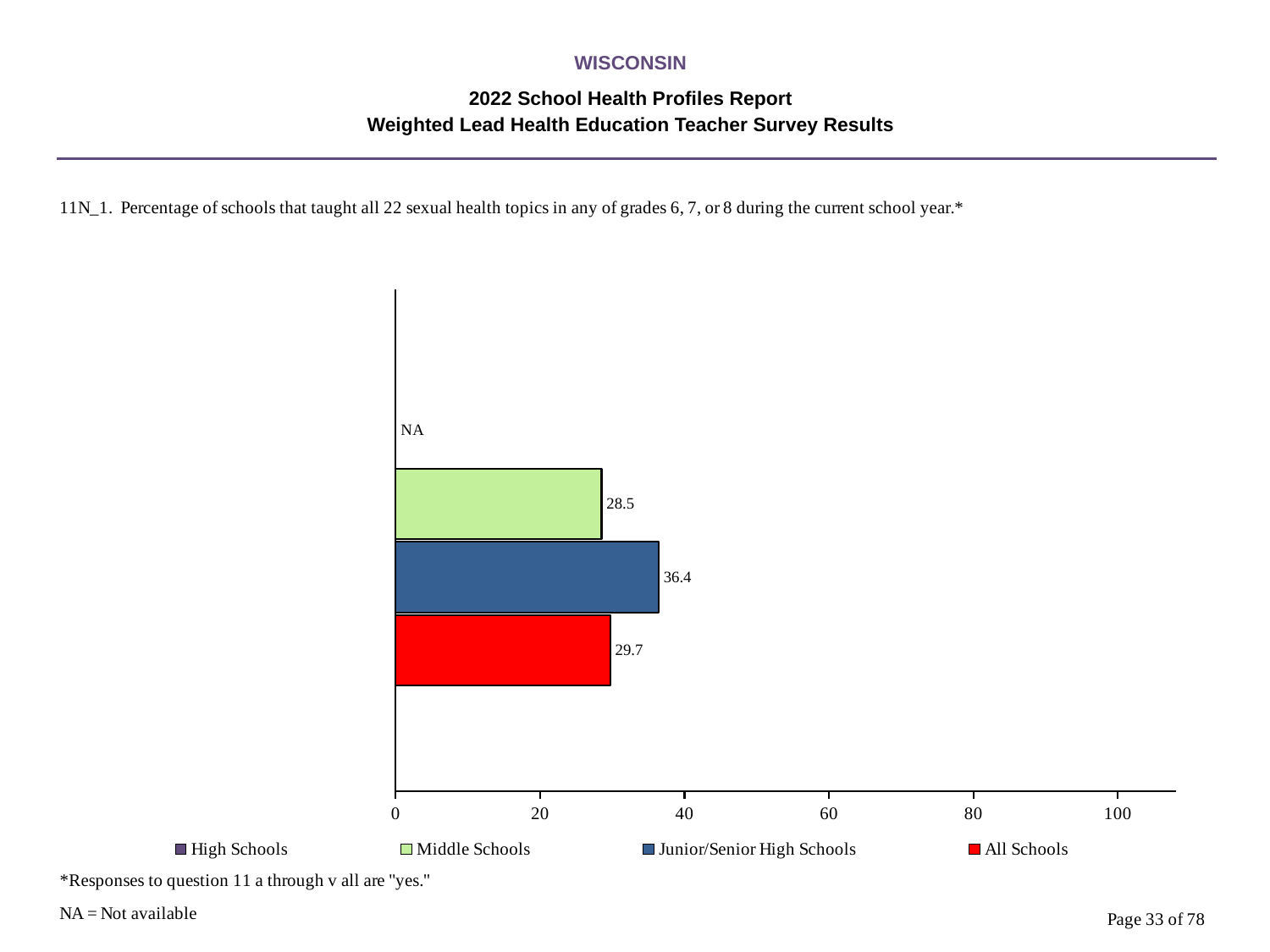
What colour is the bar for All Schools? red What kind of chart is shown? bar chart What is the difference between the values for Junior/Senior High Schools and Middle Schools? 7.9 What is the value for Middle Schools? 28.5 Which school type with a plotted bar has the lowest value? Middle Schools What is the value for All Schools? 29.7 What is shown for High Schools? NA Which school type has the highest value? Junior/Senior High Schools What is the value for Junior/Senior High Schools? 36.4 Which is larger, the value for All Schools or the value for Middle Schools? All Schools How many series does the legend list? 4 Is the value for Junior/Senior High Schools greater or less than 40? less